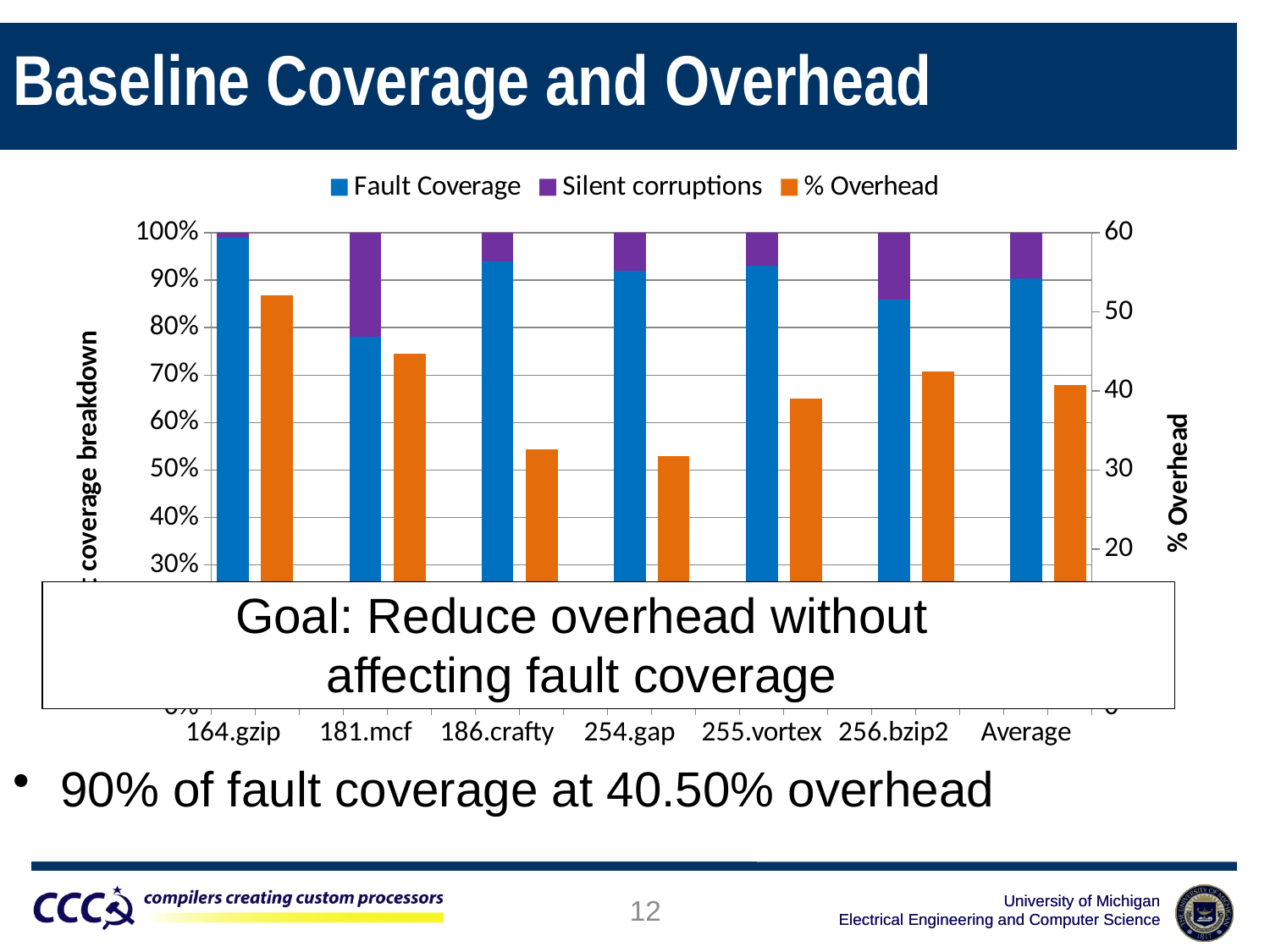
Is the Fault Coverage value for 181.mcf greater or less than 90%? less Is the % Overhead value for 256.bzip2 greater or less than 40? greater Is the % Overhead value for 164.gzip greater or less than 50? greater How many series does the legend list? 3 Which has the larger Fault Coverage, 181.mcf or 186.crafty? 186.crafty Which category has the lowest Fault Coverage? 181.mcf What is the title of the right-hand vertical axis? % Overhead How many categories are shown on the x axis? 7 Which has the larger % Overhead, 164.gzip or 254.gap? 164.gzip Which category has the highest % Overhead bar? 164.gzip What kind of chart is shown on the slide? bar chart